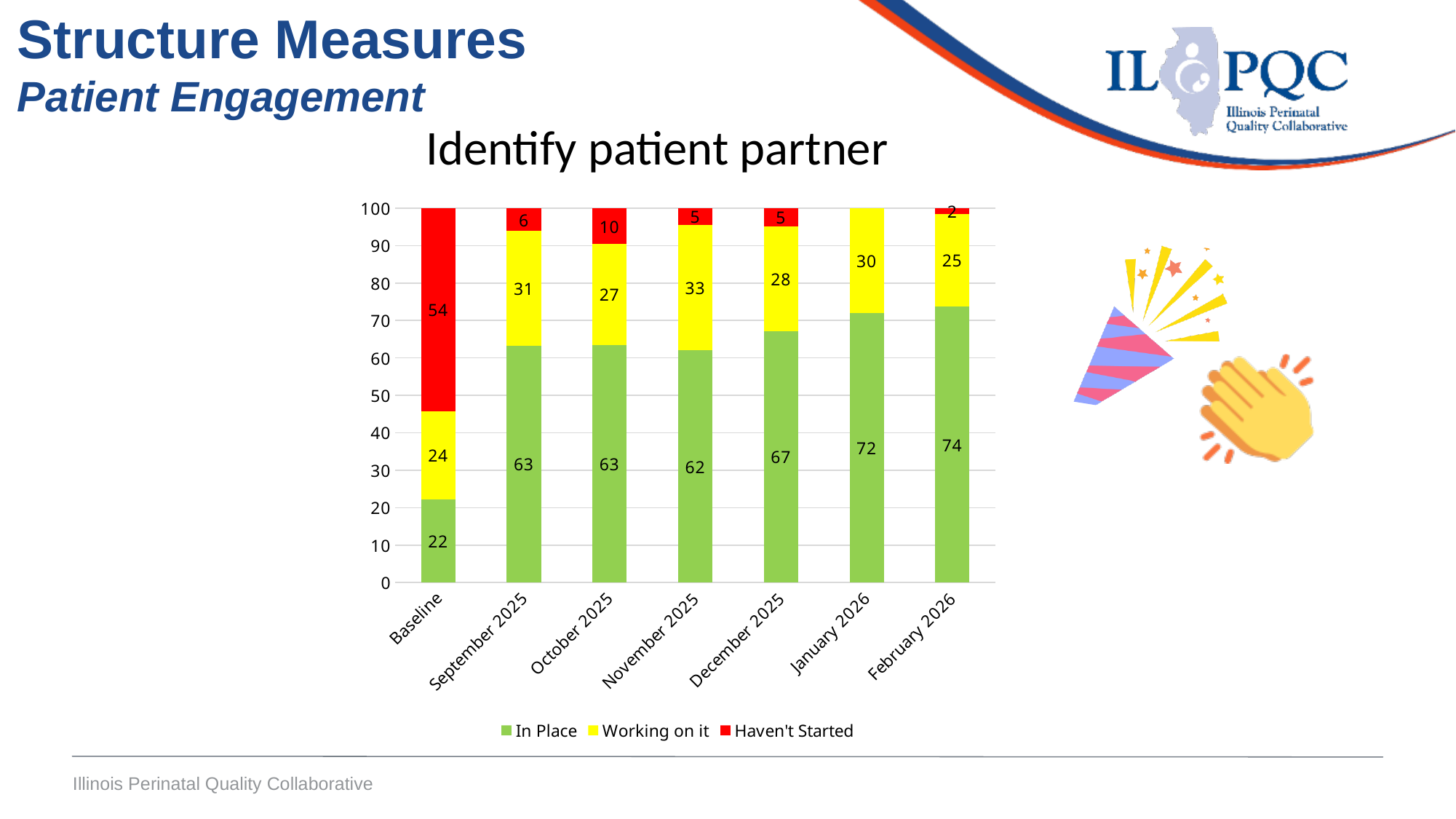
Is the Working on it value larger for January 2026 or February 2026? January 2026 How many series does the legend list? 3 What is the Haven't Started value for Baseline? 54 What is the Haven't Started value for October 2025? 10 How many categories are shown on the x axis? 7 What kind of chart is shown on the slide? Stacked bar chart Which category has the lowest In Place value? Baseline What is the difference between the In Place values for February 2026 and Baseline? 52 Which category has the highest In Place value? February 2026 What is the In Place value for February 2026? 74 What is the total of the stacked bar for December 2025? 100 What is the Working on it value for November 2025? 33